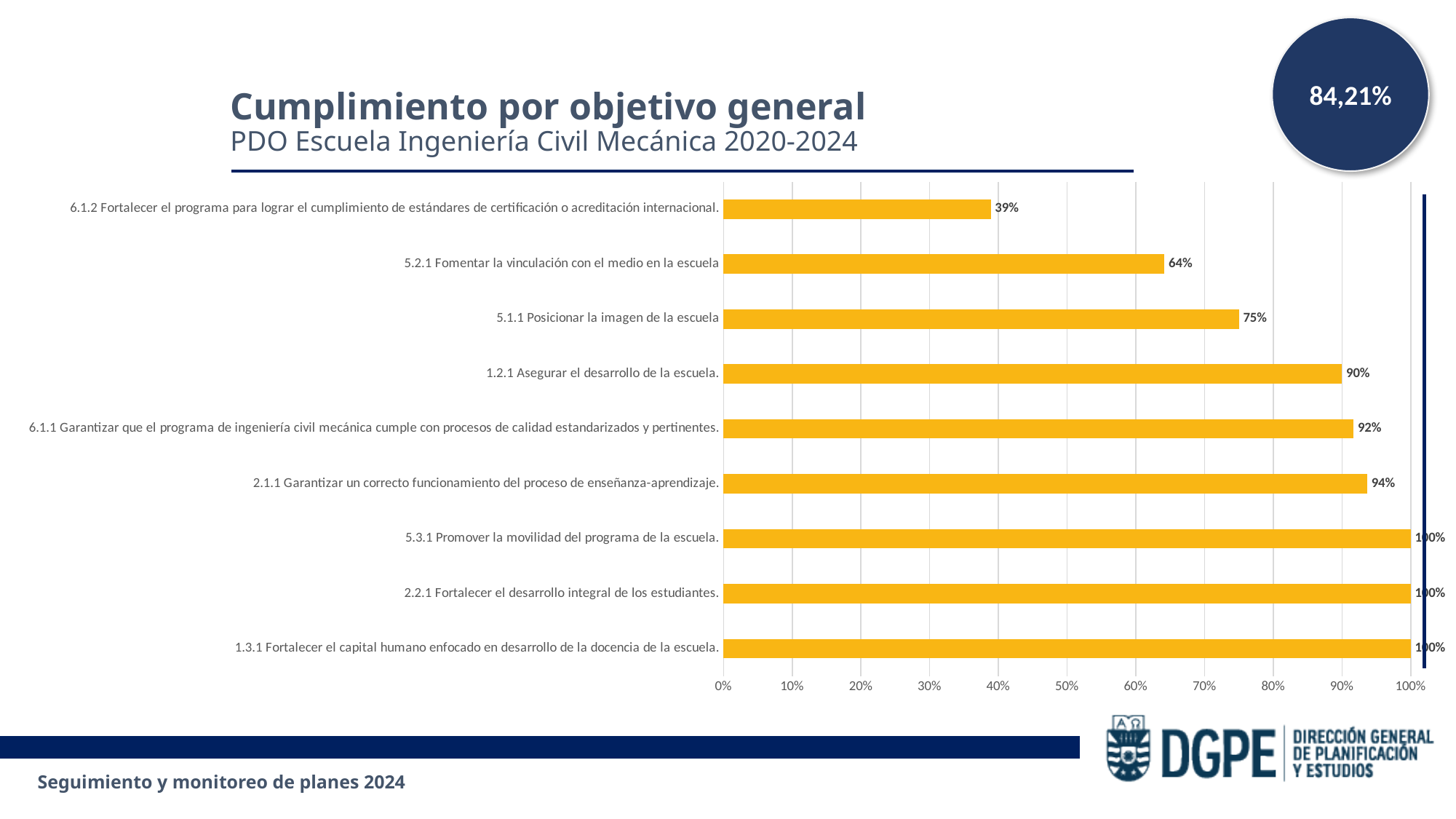
How many objectives are plotted in the chart? 9 What kind of chart is shown on the slide? Bar chart What is the difference between the values for objective 6.1.1 and objective 5.2.1? 28% What is the value for objective 5.1.1 (Posicionar la imagen de la escuela)? 75% Which objective has the lowest value? 6.1.2 Fortalecer el programa para lograr el cumplimiento de estándares de certificación o acreditación internacional. What is the value for objective 6.1.2 (Fortalecer el programa para lograr el cumplimiento de estándares de certificación o acreditación internacional)? 39% What is the value for objective 1.2.1 (Asegurar el desarrollo de la escuela)? 90% What is the value for objective 2.1.1 (Garantizar un correcto funcionamiento del proceso de enseñanza-aprendizaje)? 94% Which is larger, the value for objective 1.2.1 or the value for objective 5.1.1? 1.2.1 Asegurar el desarrollo de la escuela. How many objectives have a value of 100%? 3 What is the value for objective 5.2.1 (Fomentar la vinculación con el medio en la escuela)? 64% What is the title of the chart? Cumplimiento por objetivo general